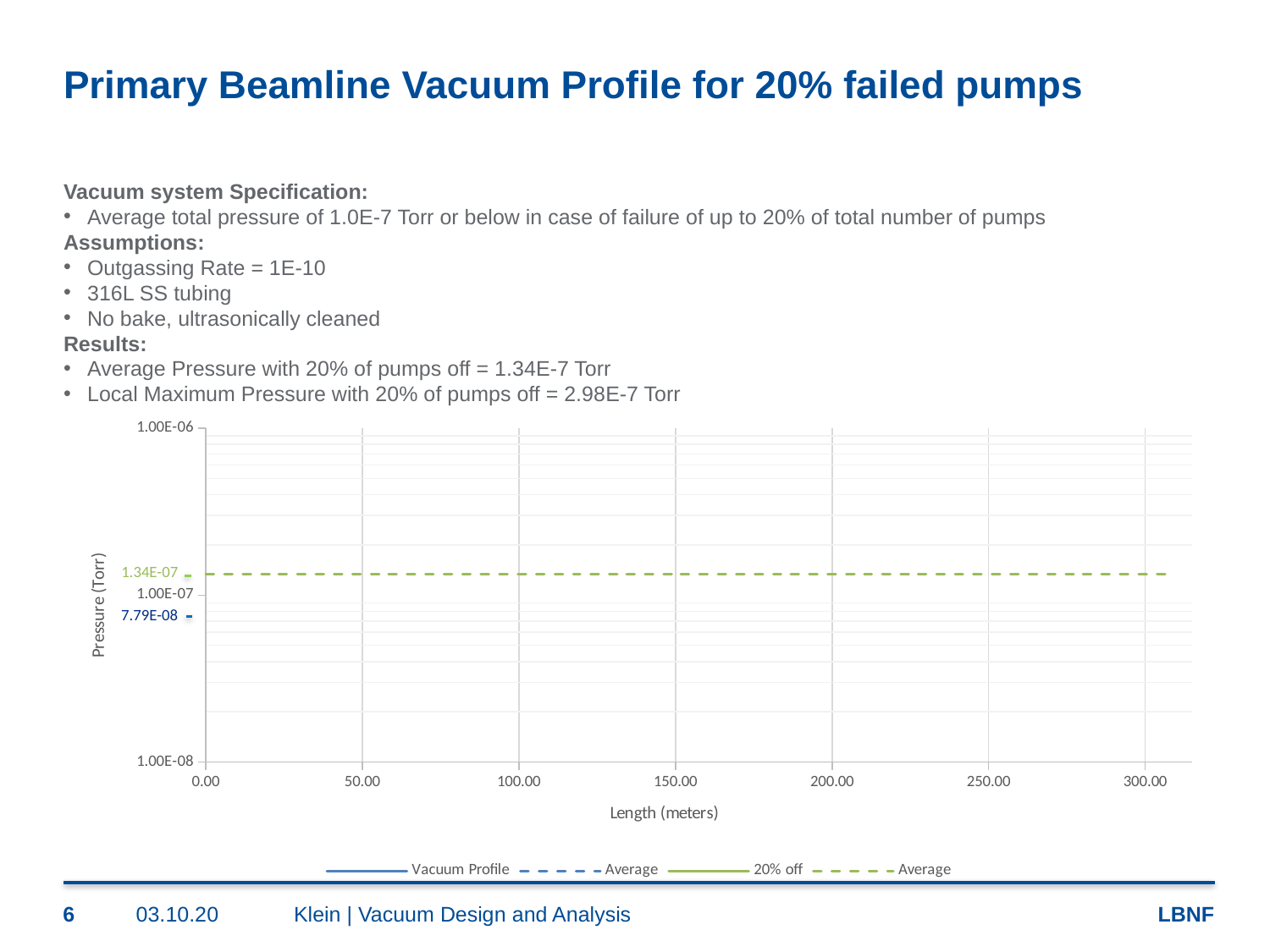
Which labeled value is larger, the green 1.34E-07 label or the blue 7.79E-08 label? 1.34E-07 What are the four entries in the chart legend? Vacuum Profile, Average, 20% off, Average Is the blue-labeled value of 7.79E-08 greater or less than 1.00E-07 Torr? less What pressure value is shown by the blue data label on the chart? 7.79E-08 Is the green dashed Average line greater or less than 1.00E-07 Torr? greater What pressure value is labeled on the green dashed Average line? 1.34E-07 What is the title of the chart's x axis? Length (meters) How many series does the chart legend list? 4 Does the green dashed Average line rise, fall, or stay flat along the x axis? stays flat What kind of chart is shown on the slide? line chart